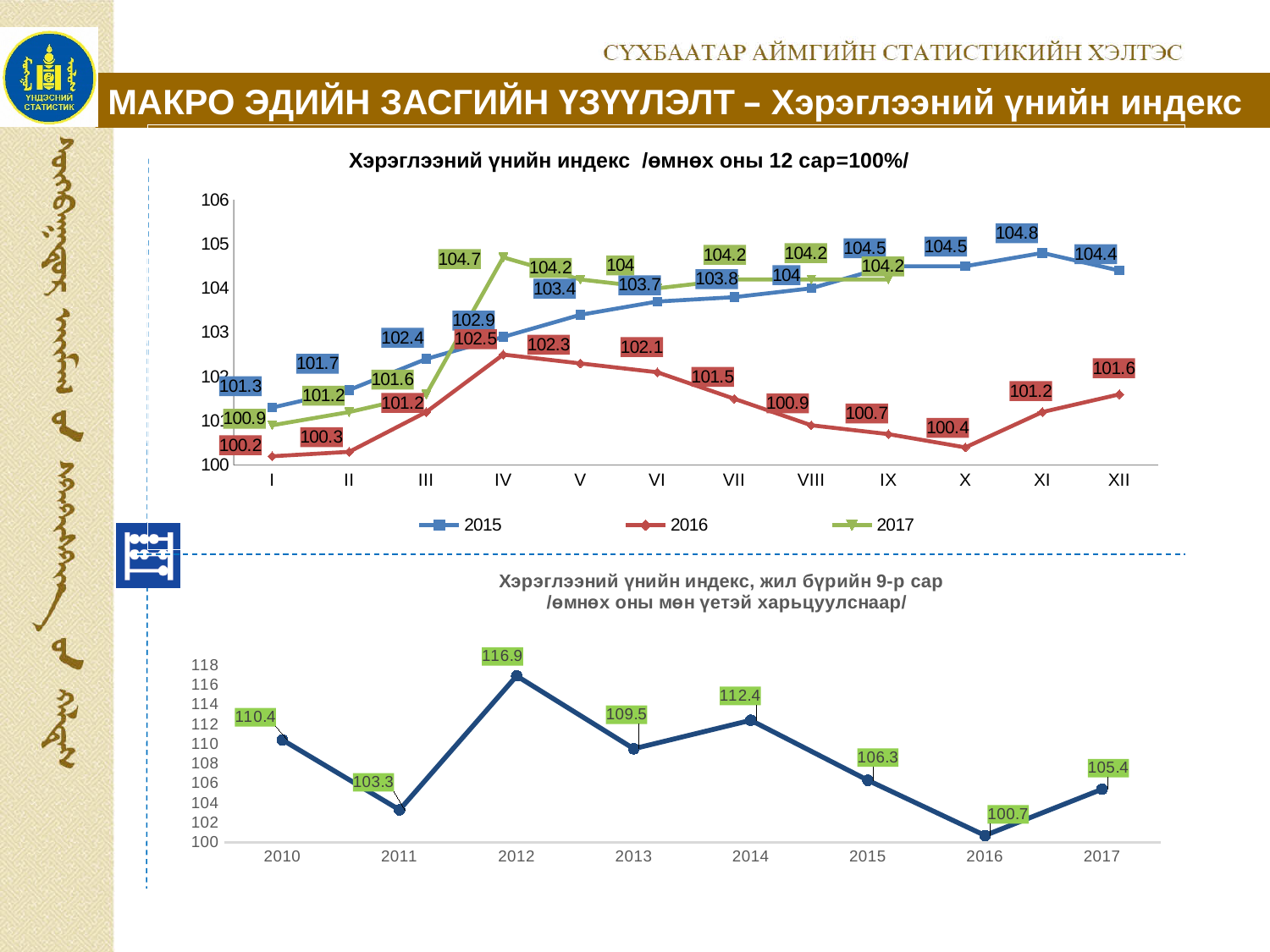
How many series does the legend of the top chart list? 3 In the bottom chart, what is the value for 2012? 116.9 In the bottom chart, what is the difference between the values for 2014 and 2015? 6.1 In the top chart, what is the value for the 2017 series in month IV? 104.7 What type of chart is the bottom chart? Line chart In the top chart, what is the value for the 2016 series in month IV? 102.5 How many years are plotted in the bottom chart? 8 In the bottom chart, which year has the lowest value? 2016 In the top chart, which is larger in month III: the 2015 value or the 2017 value? 2015 In the top chart, what is the value for the 2015 series in month XI? 104.8 In the top chart, what is the difference between the 2015 and 2016 values in month XII? 2.8 In the top chart, which month has the lowest value for the 2016 series? I